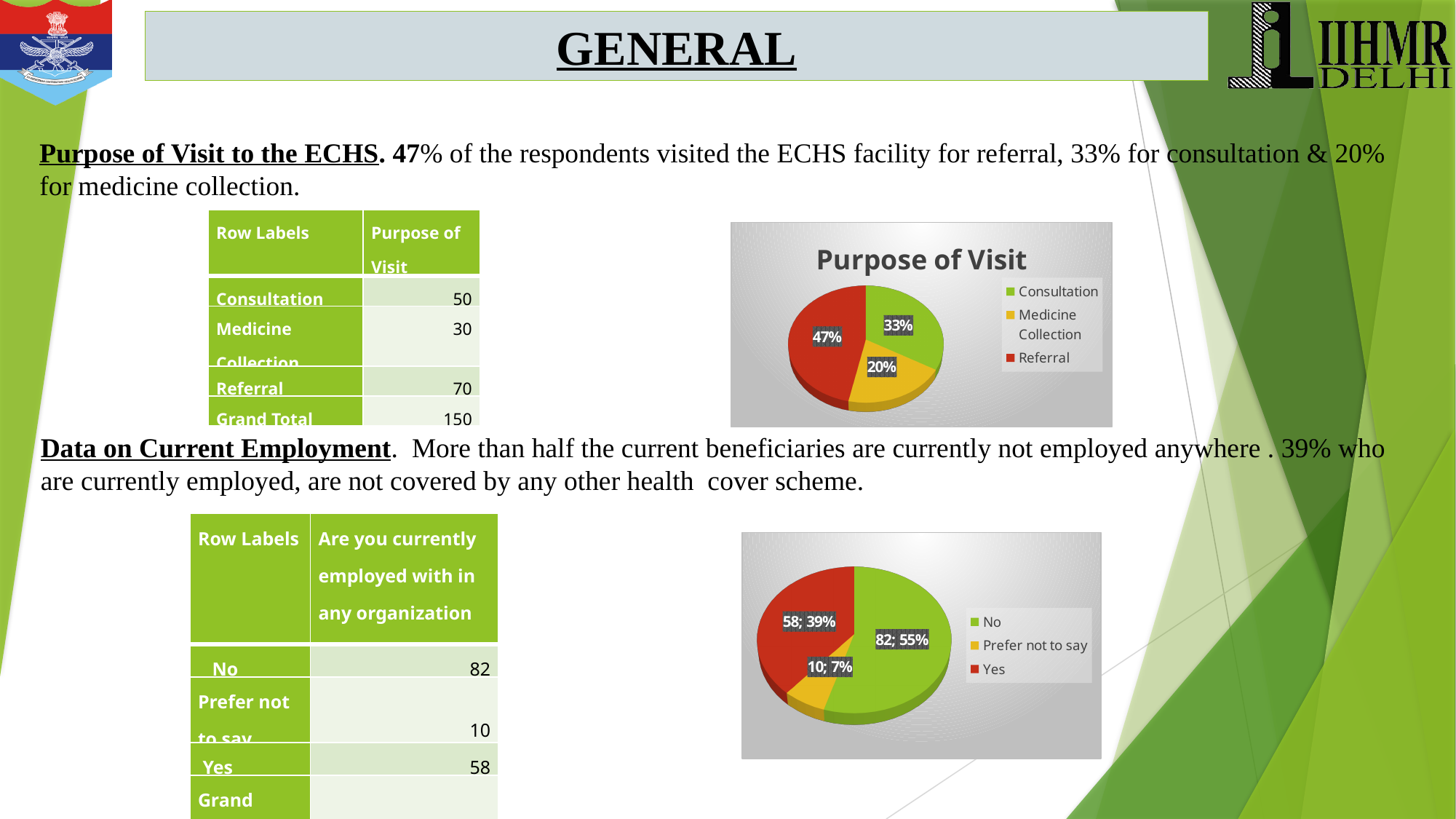
What type of chart is the 'Purpose of Visit' chart? Pie chart In the 'Purpose of Visit' pie chart, what share is labelled for Consultation? 33% In the pie chart at the bottom of the slide, what value and share are labelled for 'Yes'? 58; 39% In the 'Purpose of Visit' pie chart, which category has the smallest slice? Medicine Collection In the pie chart at the bottom of the slide, what value and share are labelled for 'No'? 82; 55% In the 'Purpose of Visit' pie chart, what share is labelled for Referral? 47% In the pie chart at the bottom of the slide, which category has the smallest slice? Prefer not to say In the 'Purpose of Visit' pie chart, what share is labelled for Medicine Collection? 20% In the pie chart at the bottom of the slide, what value and share are labelled for 'Prefer not to say'? 10; 7% In the 'Purpose of Visit' pie chart, which category has the largest slice? Referral In the 'Purpose of Visit' pie chart, how many categories does the legend list? 3 In the pie chart at the bottom of the slide, what is the difference between the values for 'No' and 'Yes'? 24